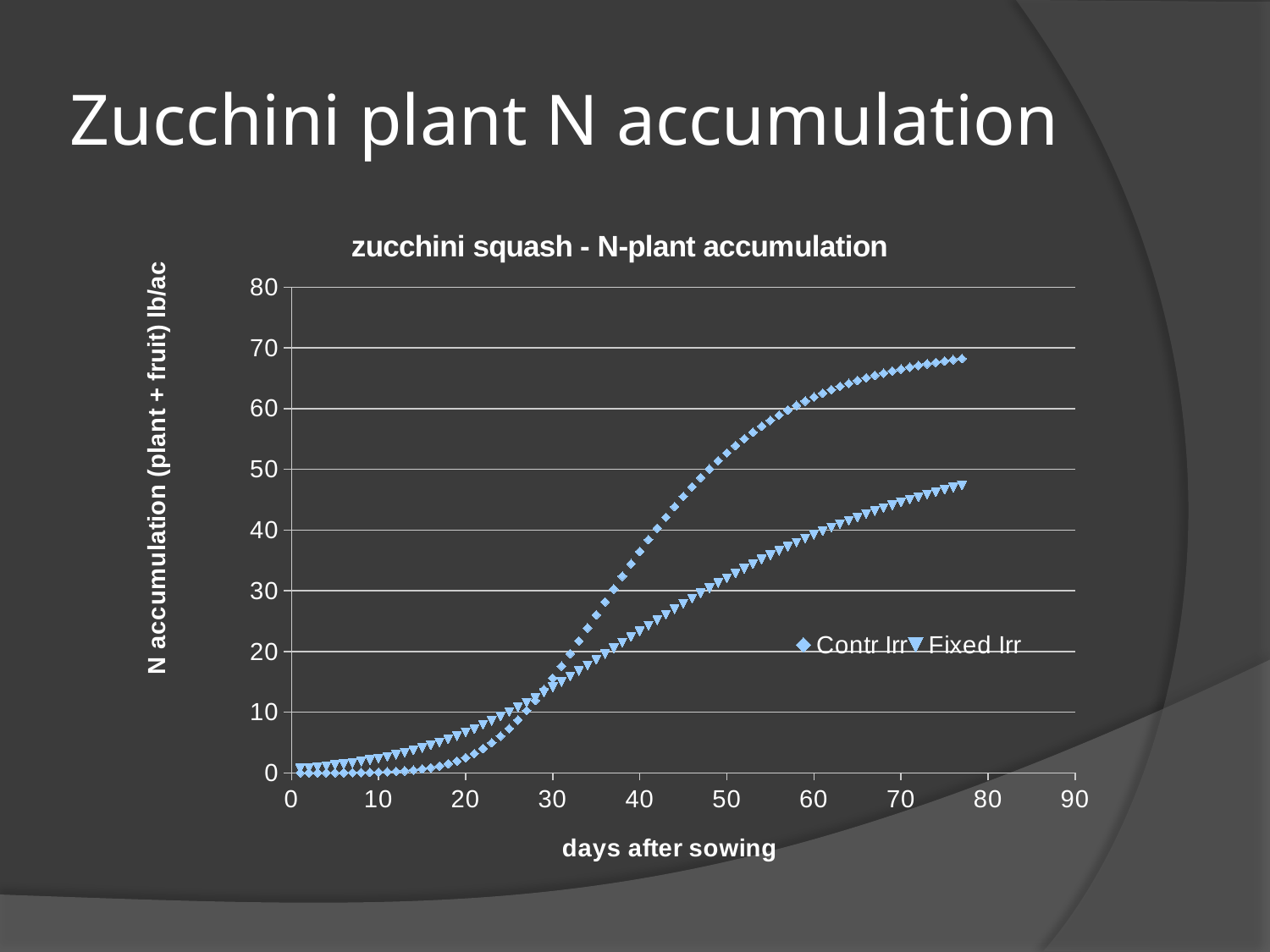
Is the Fixed Irr value at 70 days after sowing greater or less than 50? less Is the Contr Irr value at 40 days after sowing greater or less than 30? greater Which series reaches the highest N accumulation by the end of the period? Contr Irr Is the Fixed Irr value at 20 days after sowing greater or less than 10? less Which series has the higher value at 10 days after sowing, Contr Irr or Fixed Irr? Fixed Irr How many series does the legend list? 2 Do the Contr Irr values rise or fall as days after sowing increase? rise What is the label of the x axis? days after sowing Which series has the higher value at 70 days after sowing, Contr Irr or Fixed Irr? Contr Irr What is the title of the chart? zucchini squash - N-plant accumulation What kind of chart is shown on the slide? scatter chart